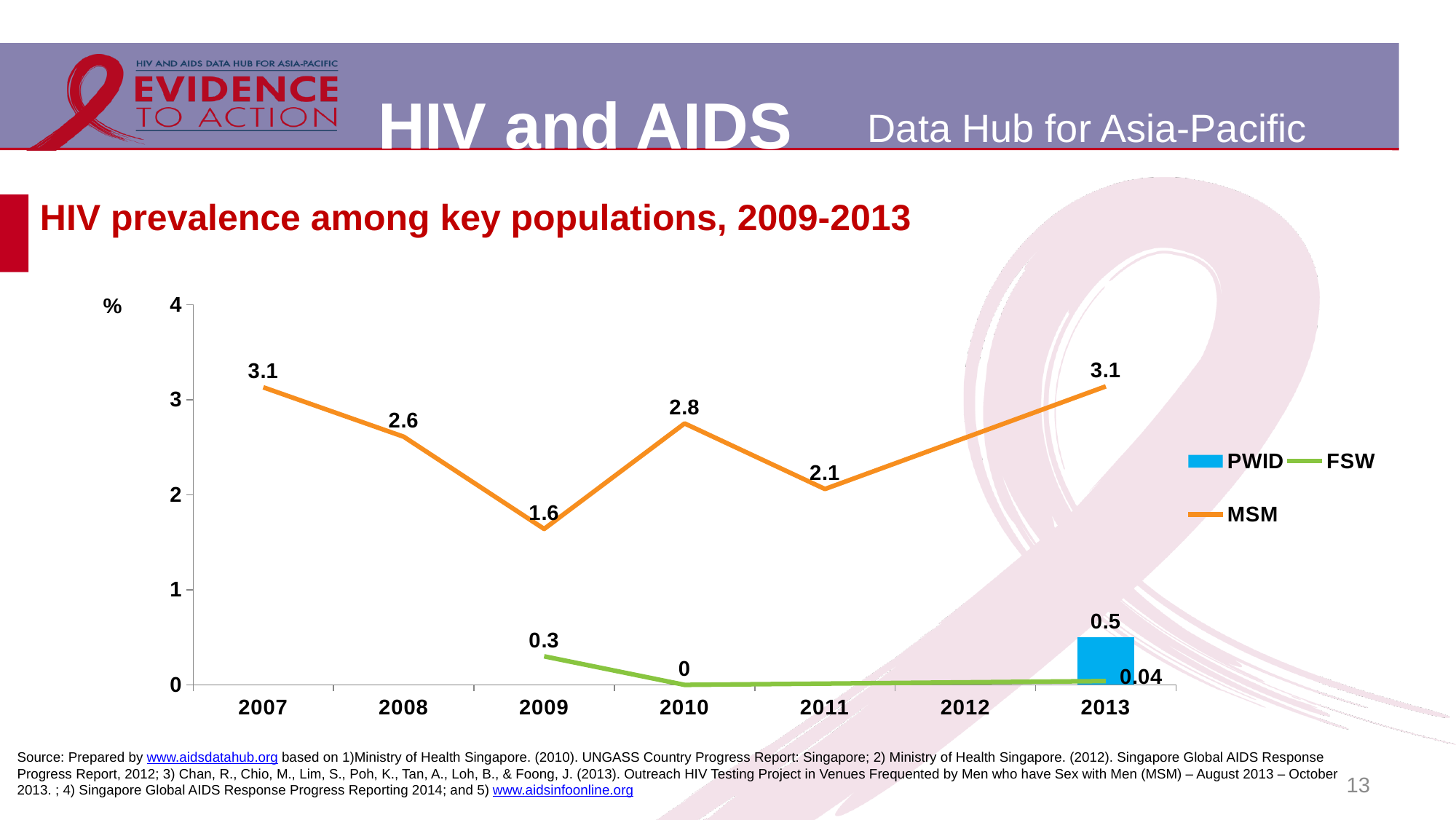
What is the HIV prevalence among MSM in 2009? 1.6 What is the difference between the MSM HIV prevalence in 2007 and in 2009? 1.5 What colour is the MSM line? Orange In which year is the MSM HIV prevalence lowest? 2009 Does the MSM HIV prevalence rise or fall from 2011 to 2013? rise Which is larger in 2013, the HIV prevalence among PWID or among FSW? PWID Is the MSM HIV prevalence in 2011 greater or less than 2? greater What is the HIV prevalence among MSM in 2010? 2.8 How many series does the legend list? 3 What is the HIV prevalence among FSW in 2009? 0.3 What is the HIV prevalence among FSW in 2013? 0.04 What is the HIV prevalence among PWID in 2013? 0.5